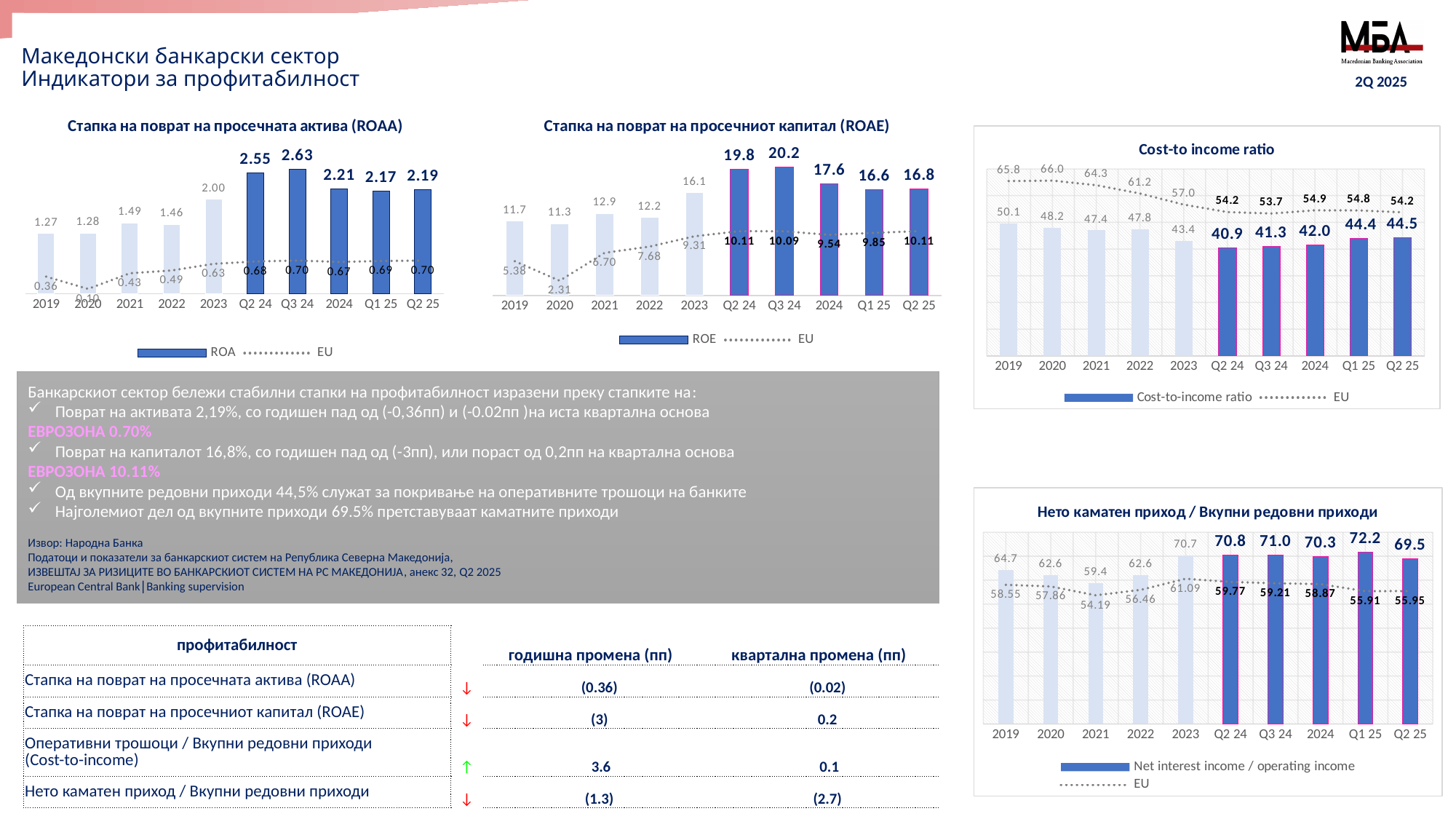
In the ROAA chart, what is the EU value for 2020? 0.10 In the ROAE chart, what is the difference between the ROE values for Q2 24 and Q2 25? 3.0 In the Cost-to income ratio chart, what is the Cost-to-income ratio for Q2 25? 44.5 In the ROAA chart, which period has the highest ROA bar? Q3 24 In the Нето каматен приход / Вкупни редовни приходи chart, what is the Net interest income / operating income value for Q1 25? 72.2 In the Cost-to income ratio chart, is the EU value for 2019 larger or smaller than the Cost-to-income ratio for 2019? larger In the ROAE chart (Стапка на поврат на просечниот капитал), what is the ROE value for Q3 24? 20.2 In the Cost-to income ratio chart, which period has the lowest Cost-to-income ratio bar? Q2 24 In the ROAE chart, which year has the lowest EU value? 2020 In the Нето каматен приход / Вкупни редовни приходи chart, how many periods are shown on the x axis? 10 In the ROAA chart (Стапка на поврат на просечната актива), what is the ROA value for Q2 25? 2.19 How many series does the legend of the Cost-to income ratio chart list? 2